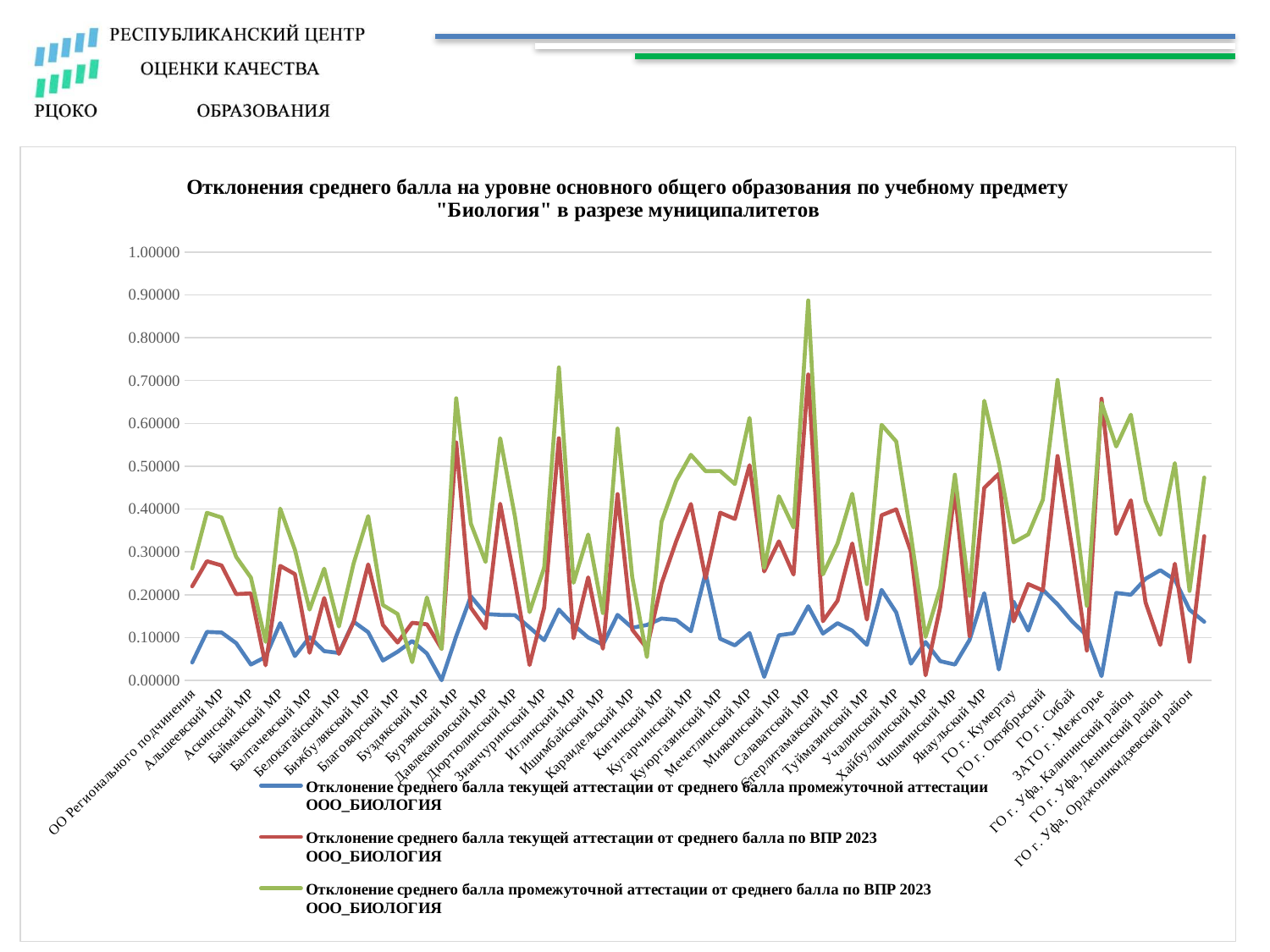
For ГО г. Уфа, Орджоникидзевский район, is the value of the green series greater or less than 0.40000? less Is the highest peak of the green series greater or less than 0.80000? greater Which colour is used for the series "Отклонение среднего балла промежуточной аттестации от среднего балла по ВПР 2023 ООО_БИОЛОГИЯ"? green What kind of chart is shown on the slide? line chart For ОО Регионального подчинения, which is larger: the green series or the blue series? the green series Which series reaches the highest value anywhere on the chart? Отклонение среднего балла промежуточной аттестации от среднего балла по ВПР 2023 ООО_БИОЛОГИЯ For ГО г. Уфа, Орджоникидзевский район, which is larger: the red series or the blue series? the blue series How many series does the legend list? 3 For ОО Регионального подчинения, is the value of the blue series greater or less than 0.10000? less What is the title of the chart? Отклонения среднего балла на уровне основного общего образования по учебному предмету "Биология" в разрезе муниципалитетов